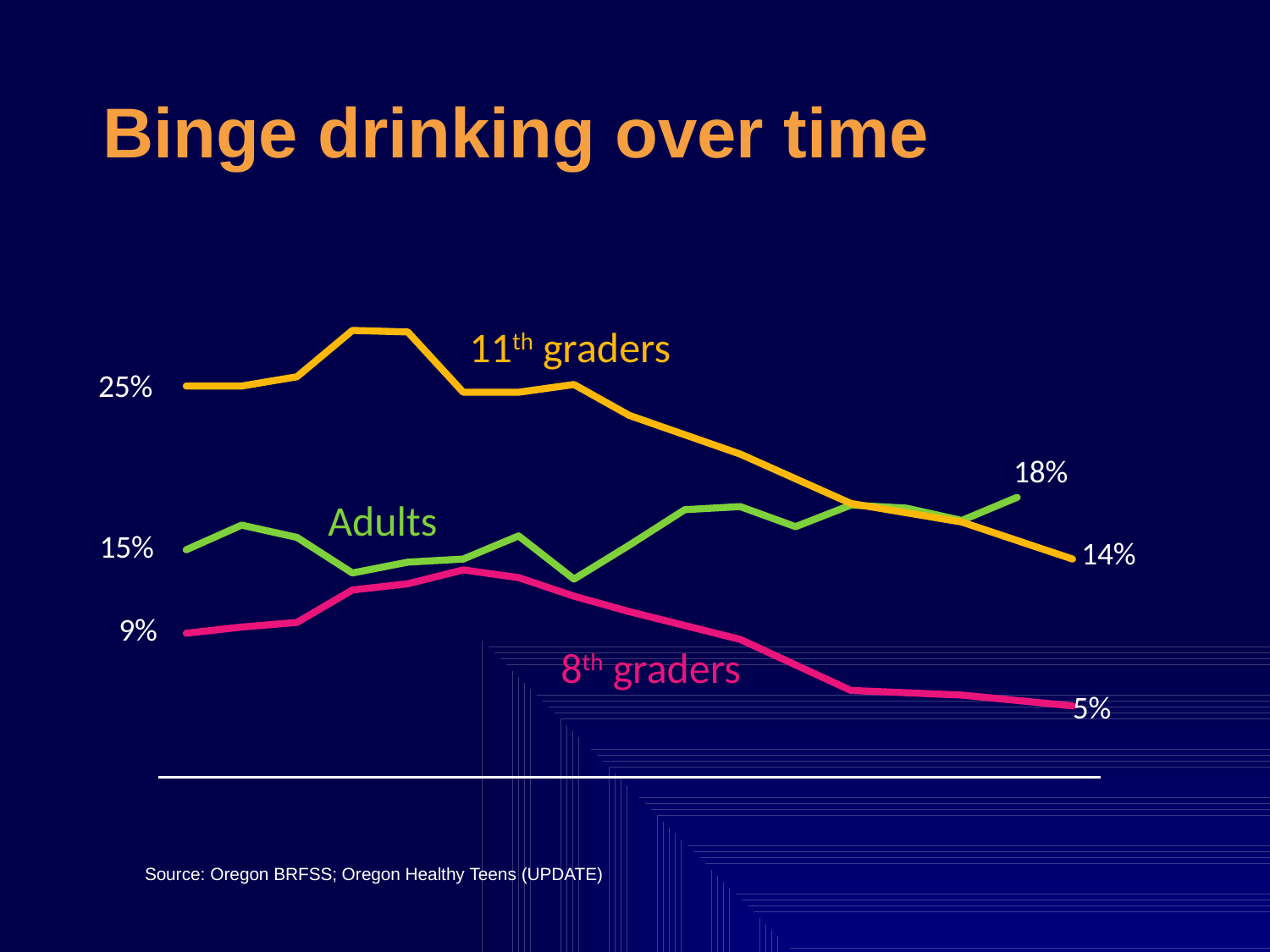
By how many percentage points did the 11th graders value change from the start (25%) to the end (14%)? 11 percentage points What is the value for Adults at the end of the series? 18% Does the 11th graders line rise or fall from its first point to its last point? fall At the end of the series, which is higher: Adults or 11th graders? Adults How many series are plotted on the chart? 3 What is the value for 11th graders at the start of the series? 25% What is the value for 8th graders at the start of the series? 9% Does the Adults line rise or fall from its first point to its last point? rise What is the title of the chart? Binge drinking over time What is the value for 8th graders at the end of the series? 5% What is the value for 11th graders at the end of the series? 14% What kind of chart is shown on the slide? line chart